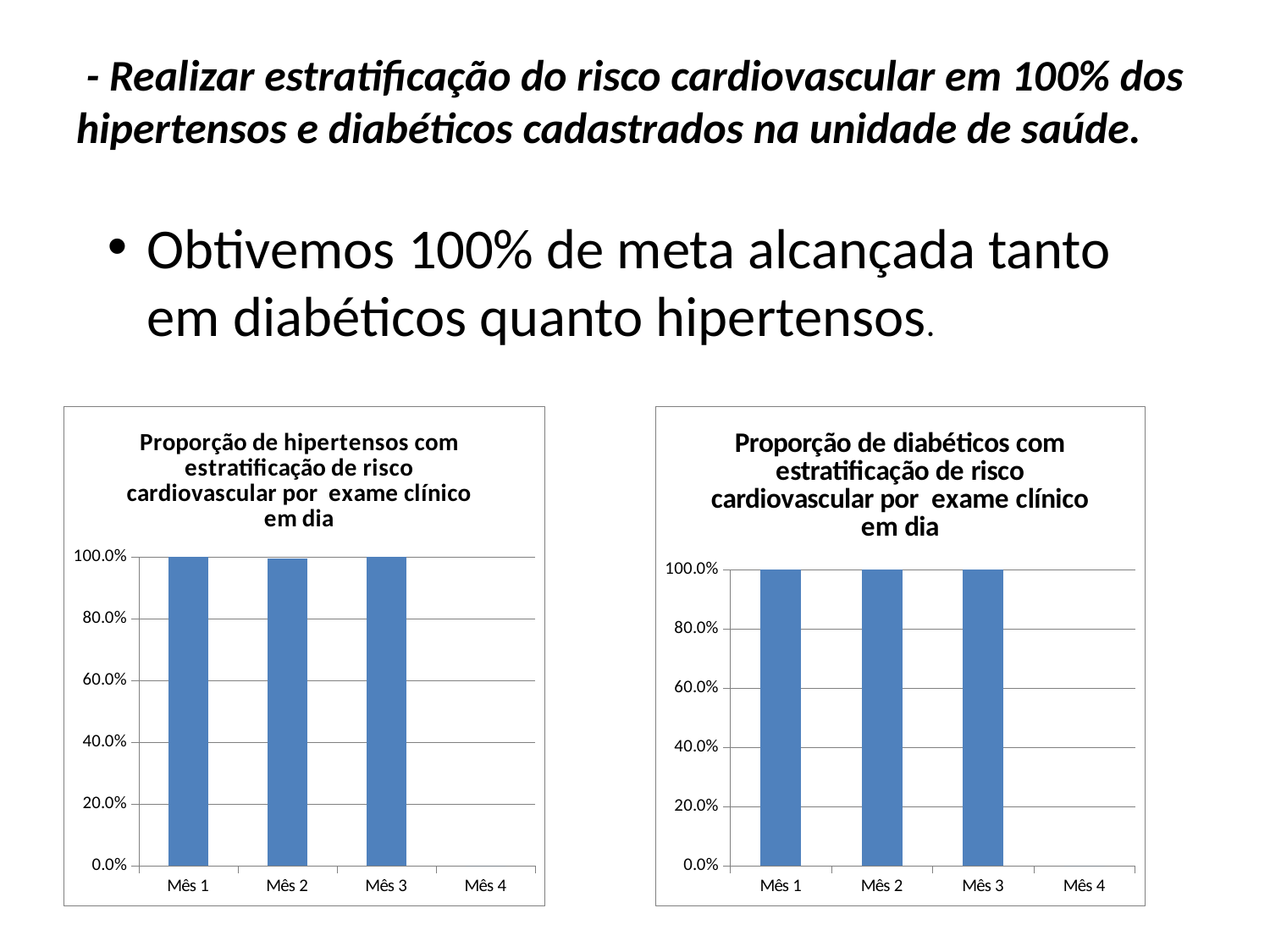
What is the title of the right chart? Proporção de diabéticos com estratificação de risco cardiovascular por exame clínico em dia In the right chart (diabéticos), what is the value for Mês 3? 100.0% What kind of chart is the right chart, 'Proporção de diabéticos com estratificação de risco cardiovascular por exame clínico em dia'? bar chart In the right chart (diabéticos), what is the value for Mês 1? 100.0% In the left chart (hipertensos), which is larger, the value for Mês 1 or the value for Mês 4? Mês 1 What kind of chart is the left chart, 'Proporção de hipertensos com estratificação de risco cardiovascular por exame clínico em dia'? bar chart In the right chart (diabéticos), is the value for Mês 4 greater or less than 20.0%? less In the right chart (diabéticos), how many categories are shown on the x axis? 4 In the left chart (hipertensos), is the value for Mês 3 greater or less than 80.0%? greater In the right chart (diabéticos), which category has the lowest value? Mês 4 In the left chart (hipertensos), what is the value for Mês 1? 100.0% In the left chart (hipertensos), how many categories are shown on the x axis? 4